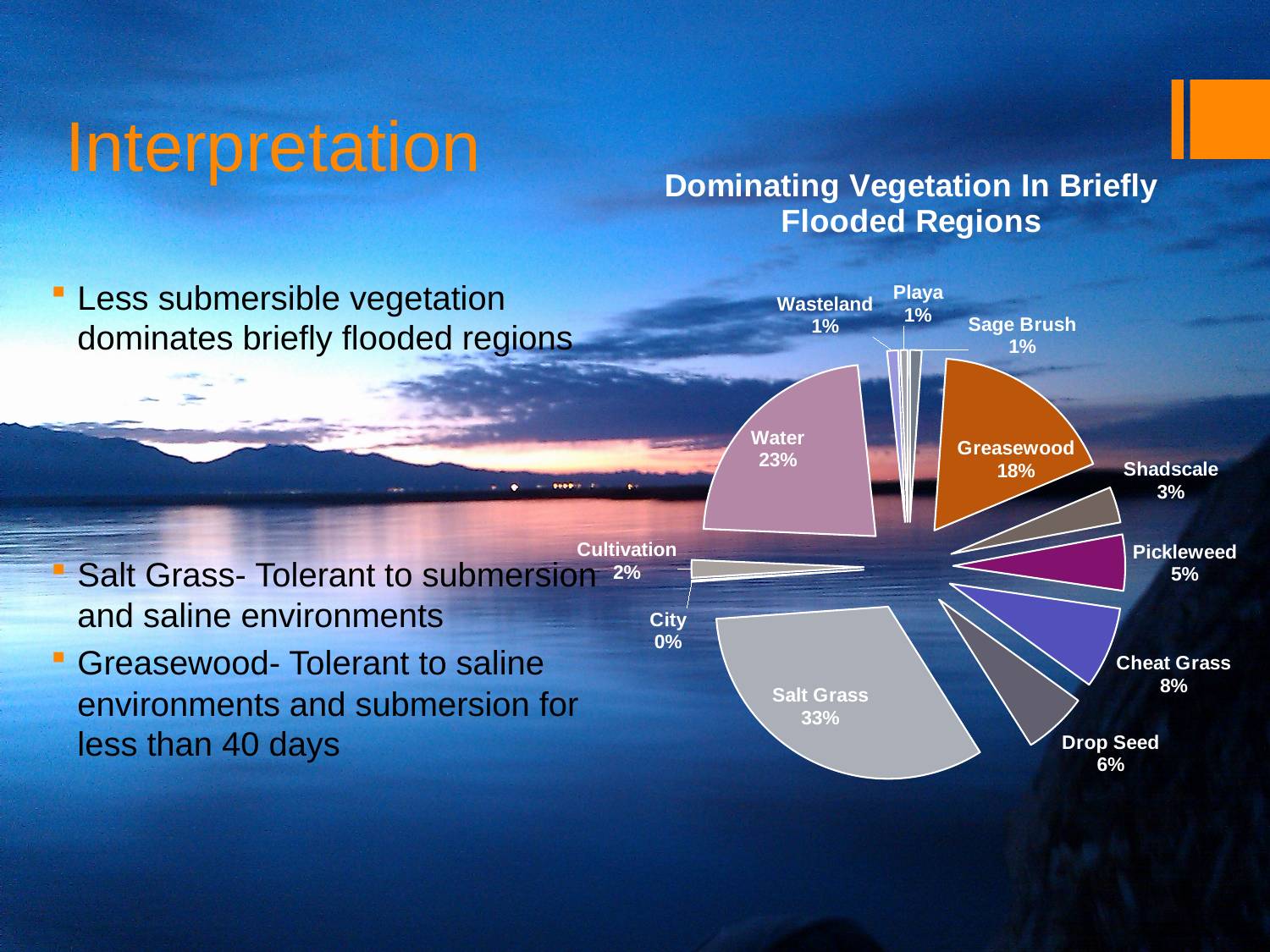
What share of the pie does Greasewood have? 18% How many categories are shown in the pie chart? 12 What kind of chart is shown on the slide? pie chart What share of the pie does Shadscale have? 3% What share of the pie does Water have? 23% Which is larger, the Pickleweed share or the Drop Seed share? Drop Seed What is the difference between the Salt Grass share and the Water share? 10% What is the title of the chart? Dominating Vegetation In Briefly Flooded Regions Which category has the largest slice of the pie? Salt Grass Which category has the smallest slice of the pie? City